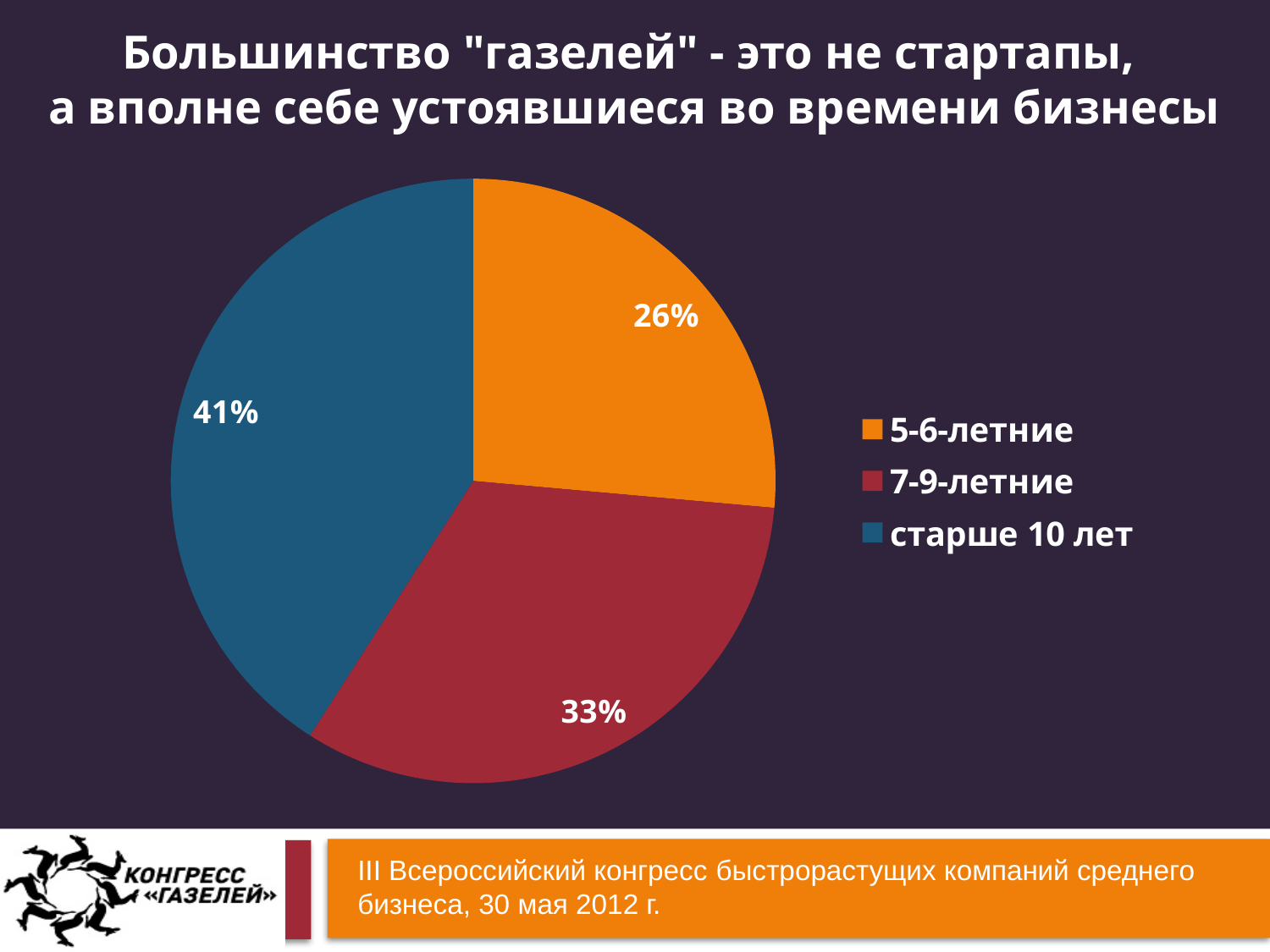
What is the difference in percentage points between the "7-9-летние" slice and the "5-6-летние" slice? 7 What share of the pie is labelled for the "5-6-летние" slice? 26% Which slice is larger: "7-9-летние" or "5-6-летние"? 7-9-летние Which category has the largest slice of the pie? старше 10 лет Which category has the smallest slice of the pie? 5-6-летние What colour is the "старше 10 лет" slice? blue What share of the pie is labelled for the "старше 10 лет" slice? 41% What share of the pie is labelled for the "7-9-летние" slice? 33% How many slices does the pie chart have? 3 What kind of chart is shown on the slide? pie chart What is the difference in percentage points between the "старше 10 лет" slice and the "5-6-летние" slice? 15 How many entries does the legend list? 3